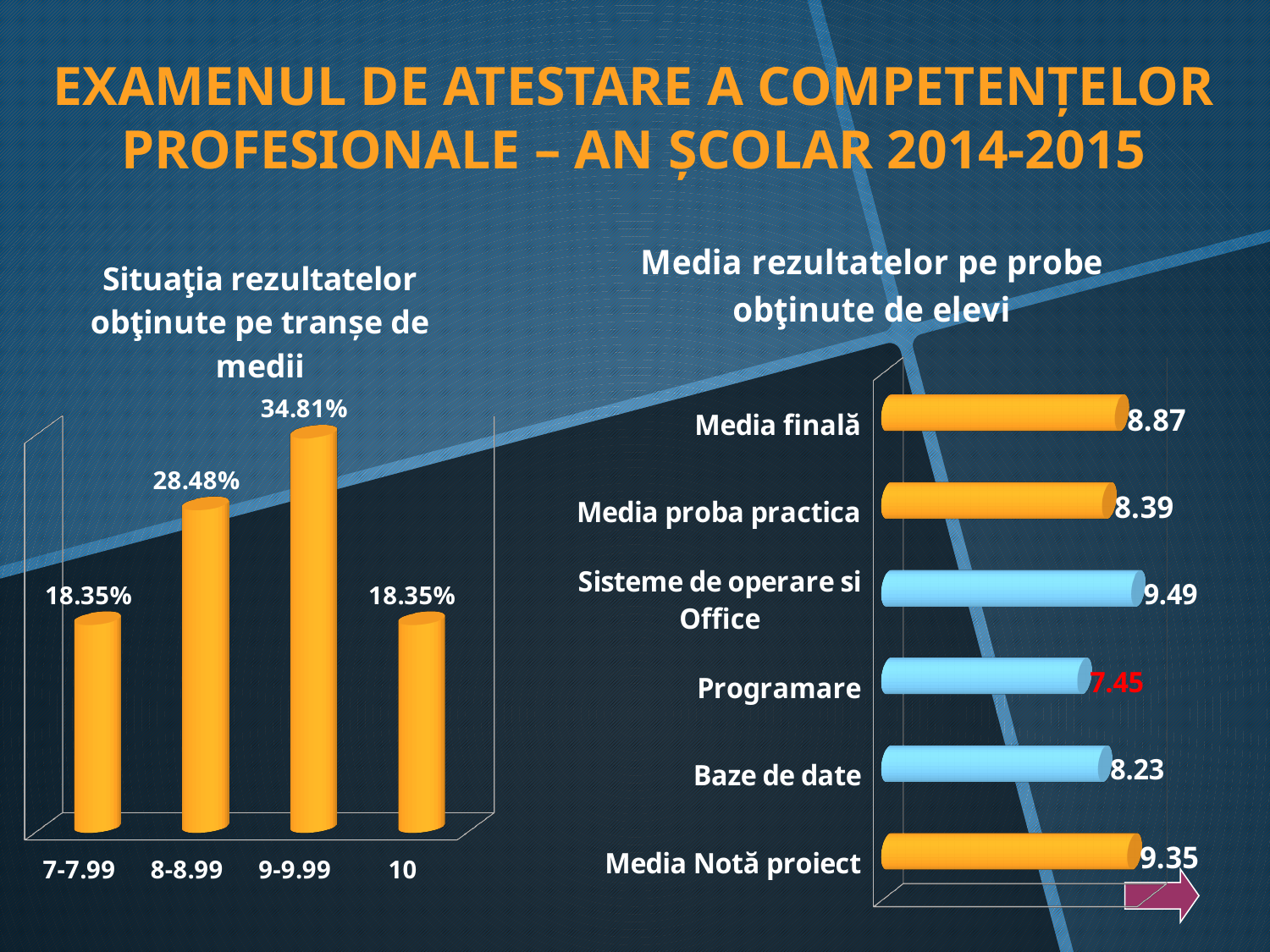
In the chart 'Media rezultatelor pe probe obţinute de elevi', which is larger: Media proba practica or Media Notă proiect? Media Notă proiect In the chart 'Media rezultatelor pe probe obţinute de elevi', what is the value for Programare? 7.45 In the chart 'Situaţia rezultatelor obţinute pe tranșe de medii', what is the value for the 8-8.99 category? 28.48% In the chart 'Media rezultatelor pe probe obţinute de elevi', what is the difference between Sisteme de operare si Office and Baze de date? 1.26 What kind of chart is 'Situaţia rezultatelor obţinute pe tranșe de medii'? Bar chart In the chart 'Situaţia rezultatelor obţinute pe tranșe de medii', what is the difference between the 9-9.99 and 8-8.99 values? 6.33% In the chart 'Situaţia rezultatelor obţinute pe tranșe de medii', which category has the highest value? 9-9.99 In the chart 'Situaţia rezultatelor obţinute pe tranșe de medii', how many categories are shown? 4 In the chart 'Media rezultatelor pe probe obţinute de elevi', which category has the lowest value? Programare In the chart 'Media rezultatelor pe probe obţinute de elevi', which category has the highest value? Sisteme de operare si Office In the chart 'Media rezultatelor pe probe obţinute de elevi', what is the value for Media finală? 8.87 In the chart 'Situaţia rezultatelor obţinute pe tranșe de medii', what is the value for the 9-9.99 category? 34.81%